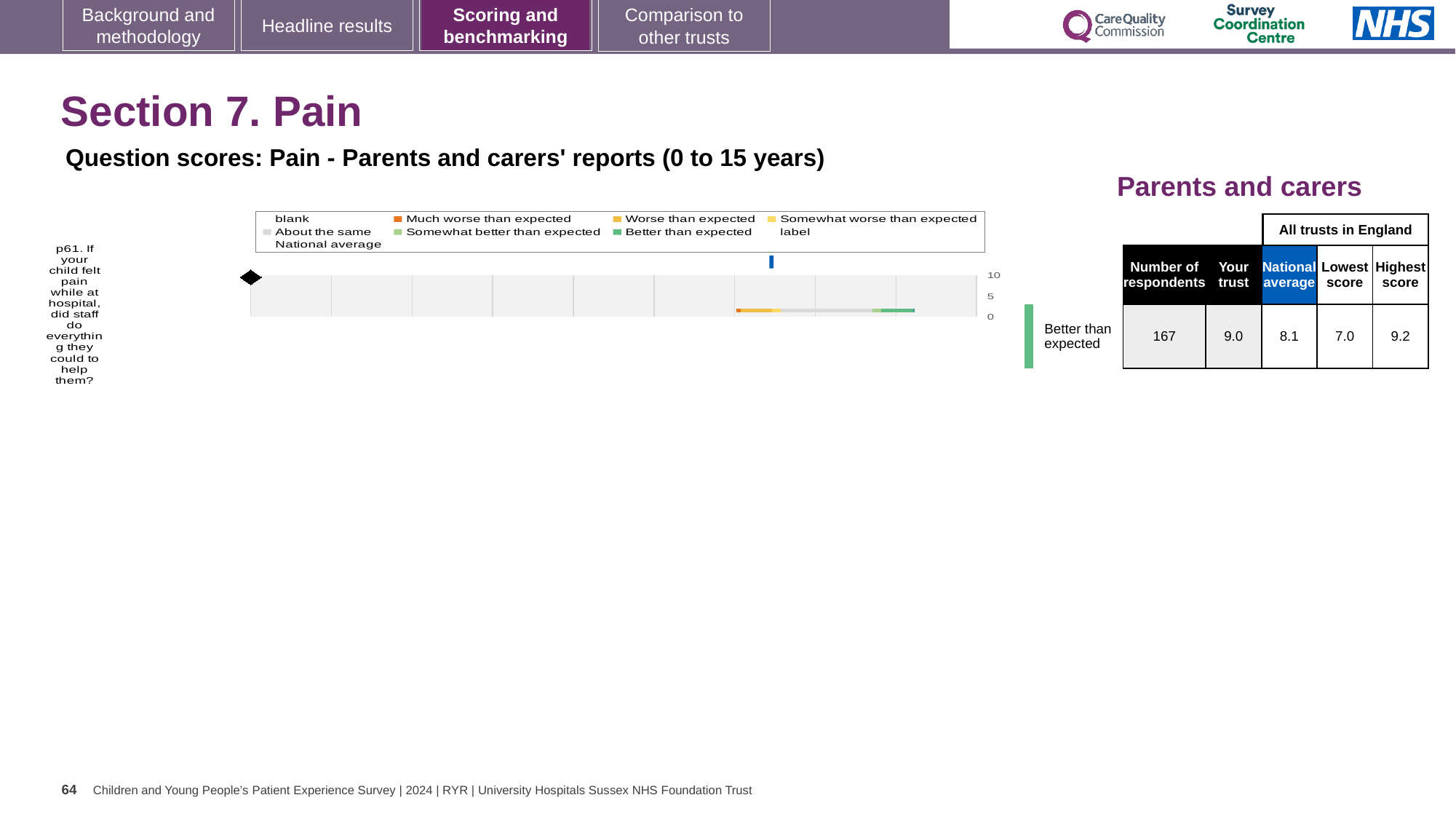
How many questions (categories) are plotted on the chart? 1 How many respondents answered question p61? 167 What is the national average score for question p61? 8.1 Which benchmarking category is the trust's p61 score assigned to? Better than expected What is the highest score among all trusts in England for question p61? 9.2 By how much does the 'Your trust' score for p61 exceed the national average? 0.9 What is the 'Your trust' score for question p61 about staff helping with pain? 9.0 What kind of chart is used to show the p61 question score? bar chart What is the lowest score among all trusts in England for question p61? 7.0 Is the 'Your trust' score for p61 greater or less than 5 on the chart's axis? greater Which is larger for p61: the 'Your trust' score or the national average? Your trust What is the difference between the highest and lowest trust scores for p61? 2.2